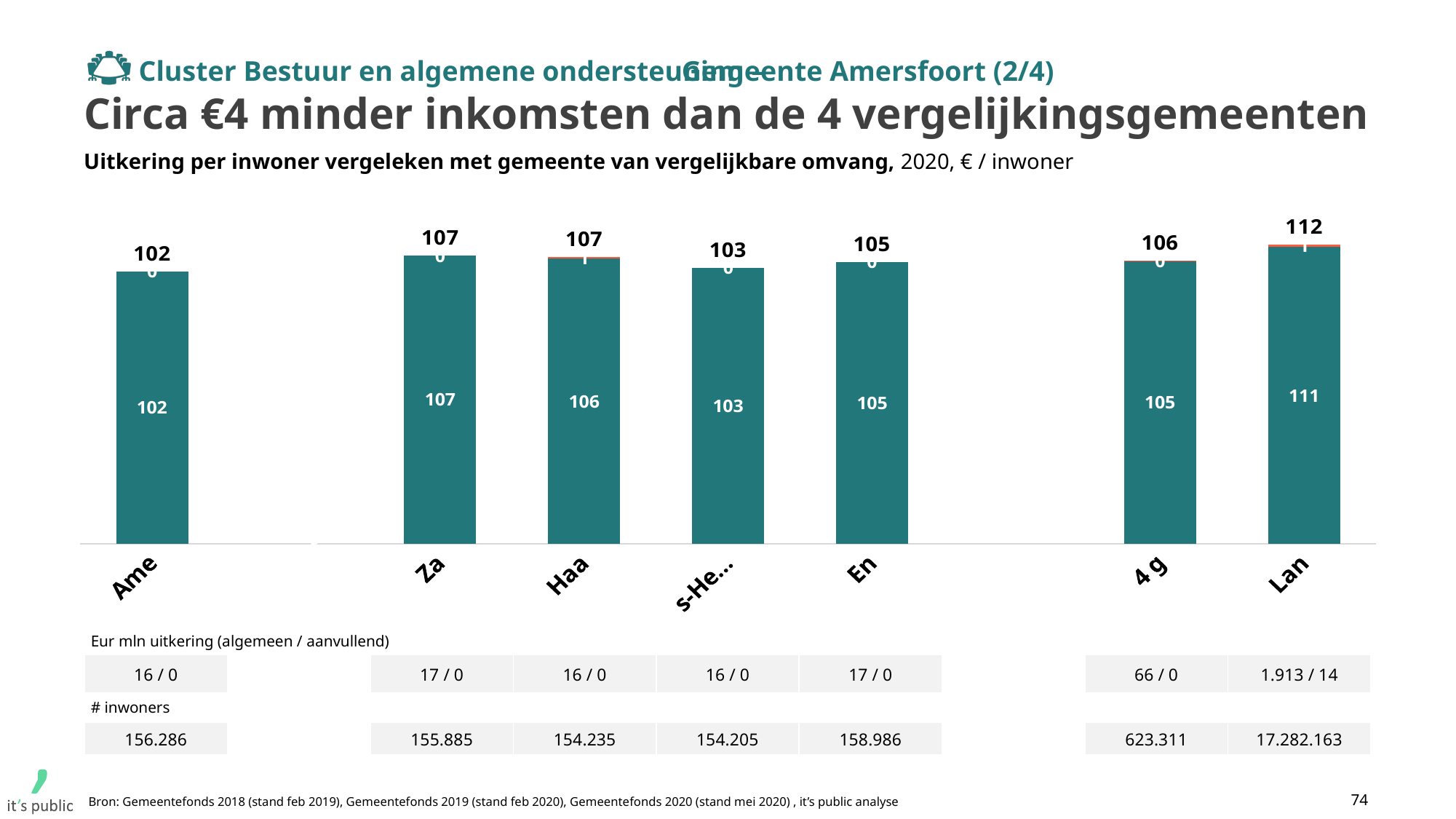
What is the value of the large teal segment in the bar for 4 g? 105 How many bars are shown in the chart? 7 What kind of chart is shown on the slide? Bar chart Which has a larger total value, Za or En? Za What is the total value shown above the bar for En? 105 What unit is stated in the chart subtitle for the values? € / inwoner What is the total value shown above the bar for Lan? 112 Which category has the lowest total value? Ame What is the value of the large teal segment in the bar for Haa? 106 What is the total value shown above the bar for Ame? 102 What is the difference between the total for Lan and the total for Ame? 10 Which category has the highest total value? Lan